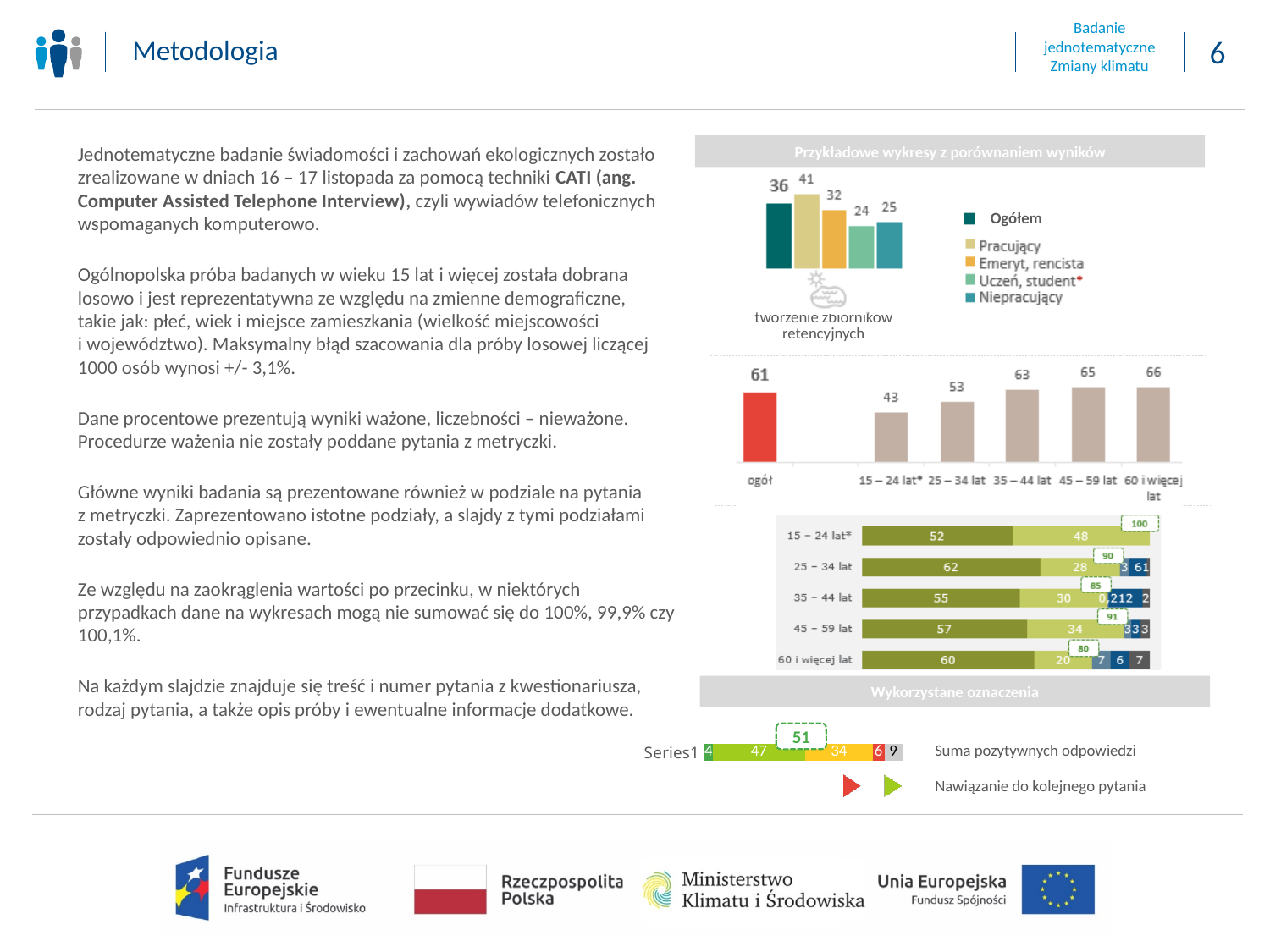
In the stacked horizontal bar chart on the right, what is the value of the first (dark green) segment for 25 – 34 lat? 62 In the chart titled 'tworzenie zbiorników retencyjnych' (top right), what is the value for Ogółem? 36 In the middle chart on the right with age groups, what is the value for ogół? 61 In the chart titled 'tworzenie zbiorników retencyjnych' (top right), how many entries does the legend list? 5 In the middle chart on the right with age groups, which age group has the lowest value? 15 – 24 lat* In the middle chart on the right with age groups, which age group has the highest value? 60 i więcej lat What type of chart is the middle chart on the right with age groups? bar chart In the chart titled 'tworzenie zbiorników retencyjnych' (top right), what is the value for Pracujący? 41 In the chart titled 'tworzenie zbiorników retencyjnych' (top right), which group has the lowest value? Uczeń, student* In the chart titled 'tworzenie zbiorników retencyjnych' (top right), what is the difference between the values for Pracujący and Emeryt, rencista? 9 In the middle chart on the right with age groups, do the values rise or fall from 15 – 24 lat* to 60 i więcej lat? rise In the middle chart on the right with age groups, what is the difference between the values for 60 i więcej lat and 15 – 24 lat*? 23